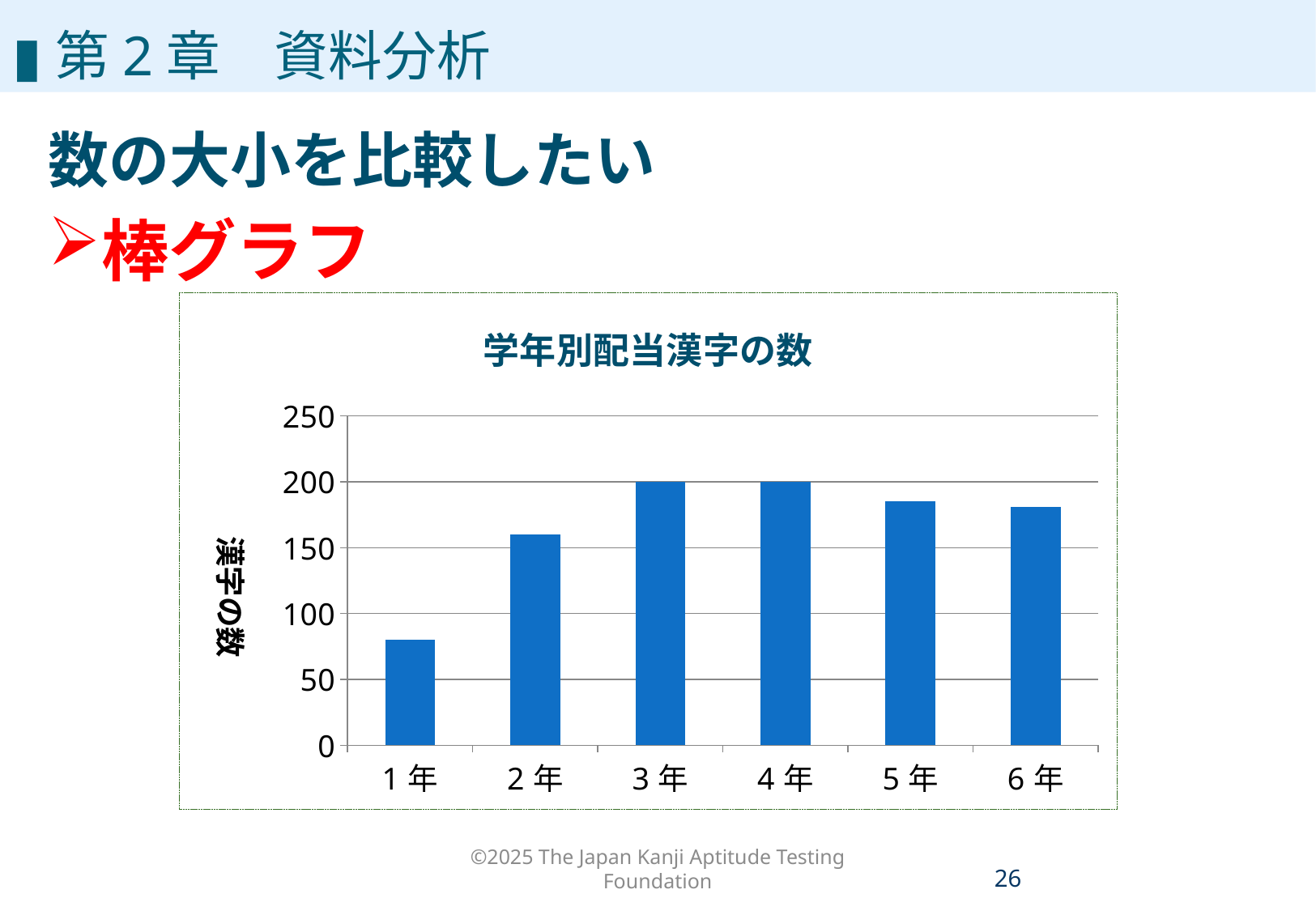
Which grade has the lowest value in the chart? 1年 Is the value for 2年 greater or less than 150? greater Is the value for 6年 greater or less than 150? greater What is the title of the chart? 学年別配当漢字の数 Which is larger, the value for 2年 or the value for 5年? 5年 Do the values rise or fall from 1年 to 3年? rise How many grade categories are shown on the x axis of the chart? 6 Is the value for 1年 greater or less than 100? less What kind of chart is shown on the slide? bar chart What is the value for 3年 in the chart? 200 What is the value for 4年 in the chart? 200